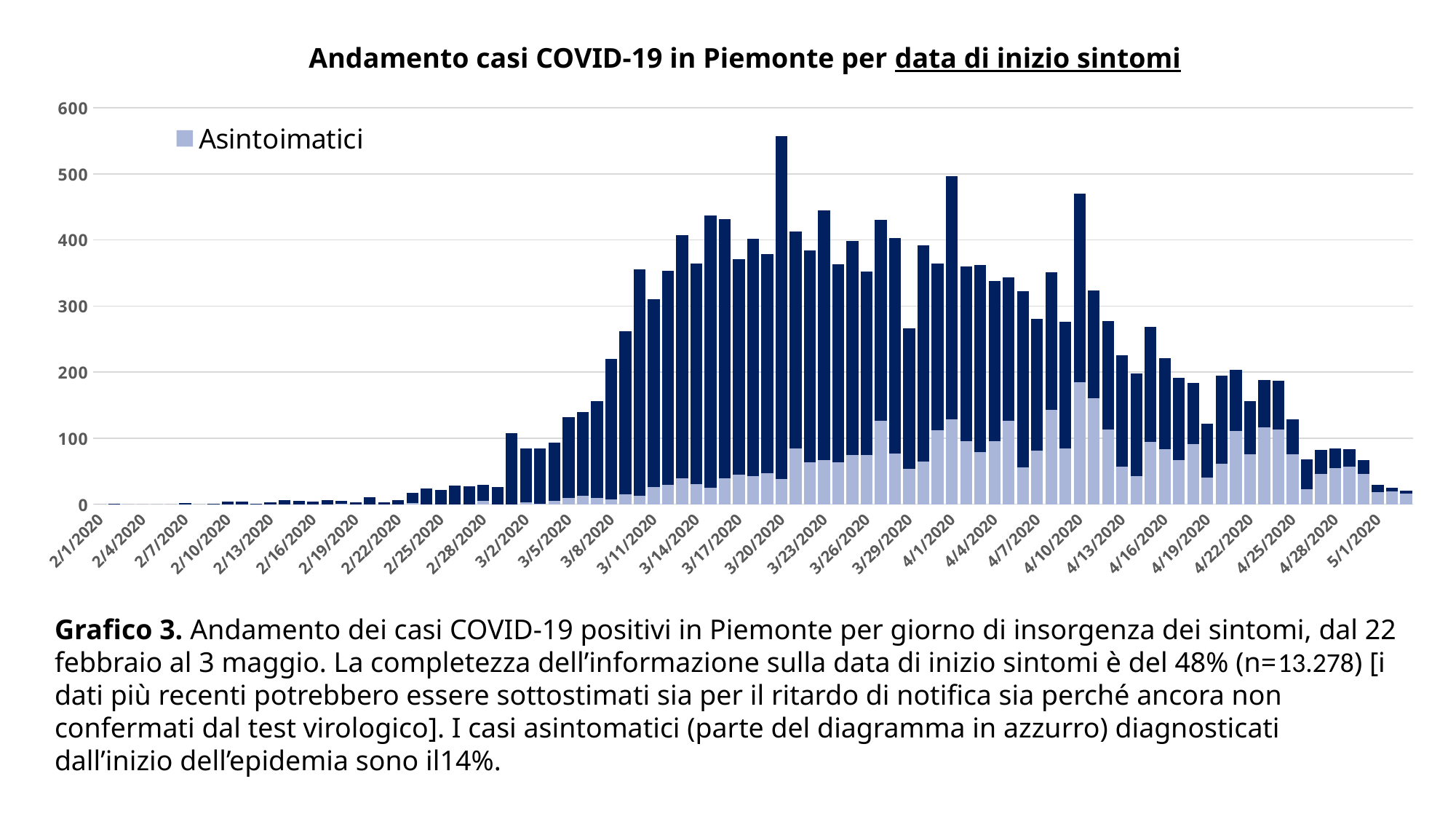
Is the value for 5/1/2020 greater or less than 100? less Do the bar values generally rise or fall from 4/10/2020 to 5/1/2020? fall Do the bar values generally rise or fall from 2/22/2020 to 3/20/2020? rise Is the value for 3/2/2020 greater or less than 200? less What is the name of the series shown in the legend? Asintoimatici What kind of chart is shown on the slide? bar chart Is the value for 4/10/2020 greater or less than 400? greater How many series does the chart's legend list? 1 What is the title of the chart? Andamento casi COVID-19 in Piemonte per data di inizio sintomi Which date has the highest bar in the chart? 3/20/2020